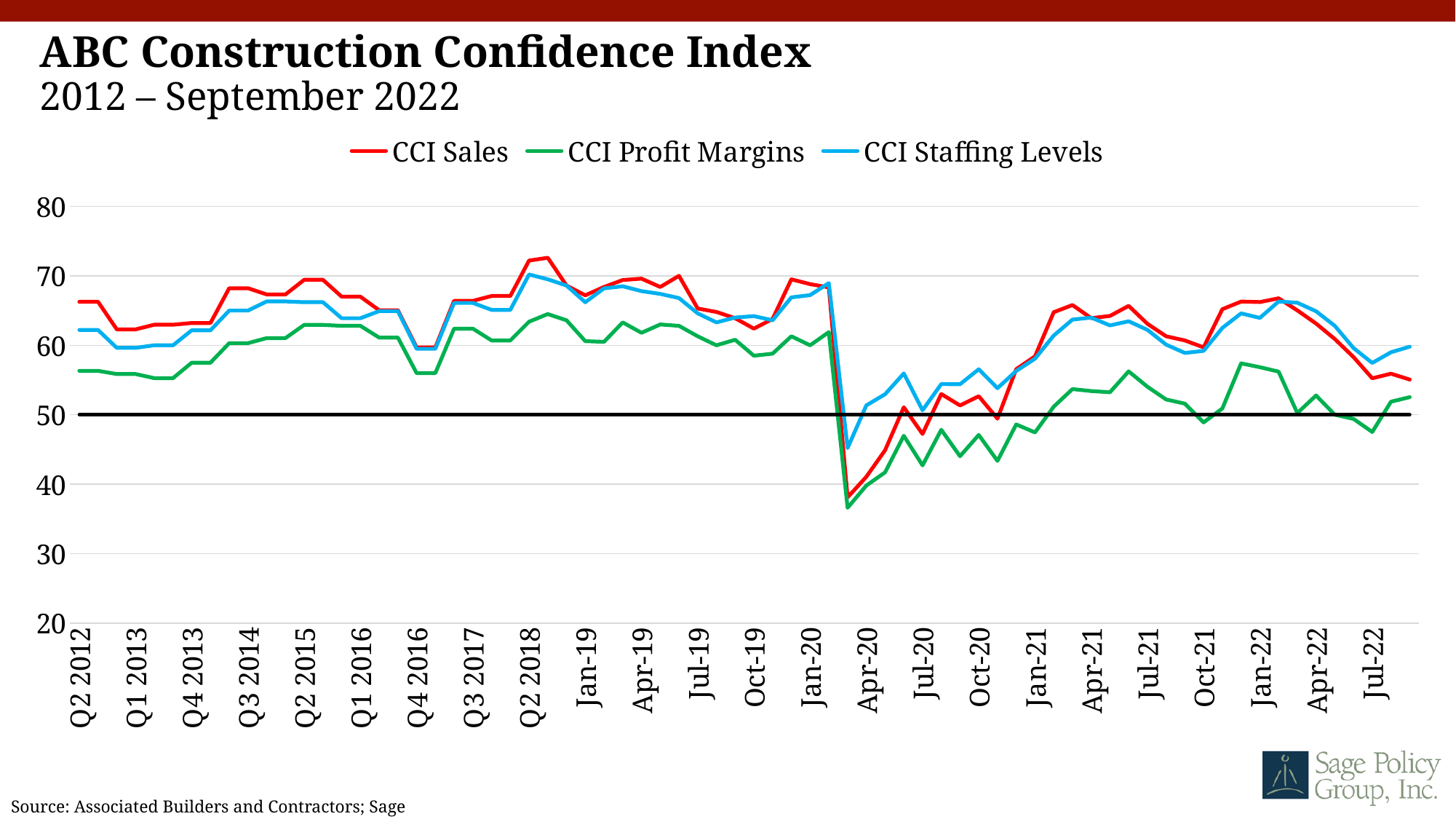
At Jul-22, which is larger: CCI Staffing Levels or CCI Profit Margins? CCI Staffing Levels At Q2 2012, which is larger: CCI Sales or CCI Profit Margins? CCI Sales Is the value for CCI Sales at Apr-20 greater or less than 50? less Which series has the lowest value at Q2 2012? CCI Profit Margins Which series is shown in green in the legend? CCI Profit Margins Is the value for CCI Profit Margins at Q2 2012 greater or less than 50? greater What kind of chart is shown on the slide? Line chart Is the value for CCI Profit Margins at Q2 2018 greater or less than 70? less How many series does the legend list? 3 What is the title of the chart? ABC Construction Confidence Index Does CCI Sales rise or fall from Jan-22 to Jul-22? Fall